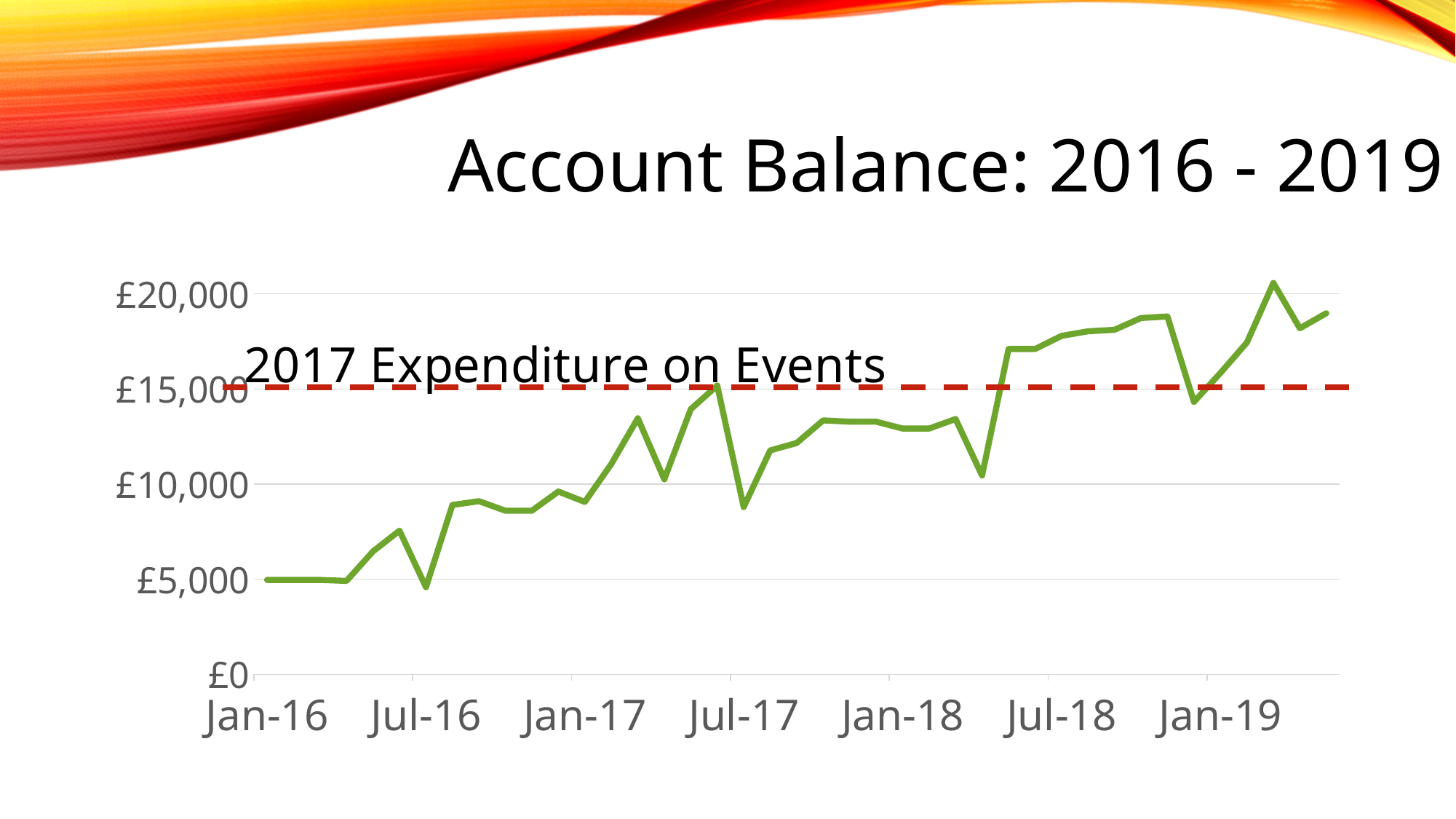
What is the title of the chart? Account Balance: 2016 - 2019 At what value on the y axis is the dashed '2017 Expenditure on Events' line drawn? £15,000 Which is larger, the account balance at Jan-16 or at Jul-18? Jul-18 What does the dashed red horizontal line represent? 2017 Expenditure on Events Is the account balance at Jul-16 greater or less than £10,000? less Overall, does the account balance rise or fall from Jan-16 to 2019? rise What kind of chart is shown on the slide? line chart Which is larger, the account balance at Jan-16 or at Jan-18? Jan-18 Is the account balance at Jan-16 greater or less than £10,000? less Is the account balance at Jan-18 greater or less than £15,000? less